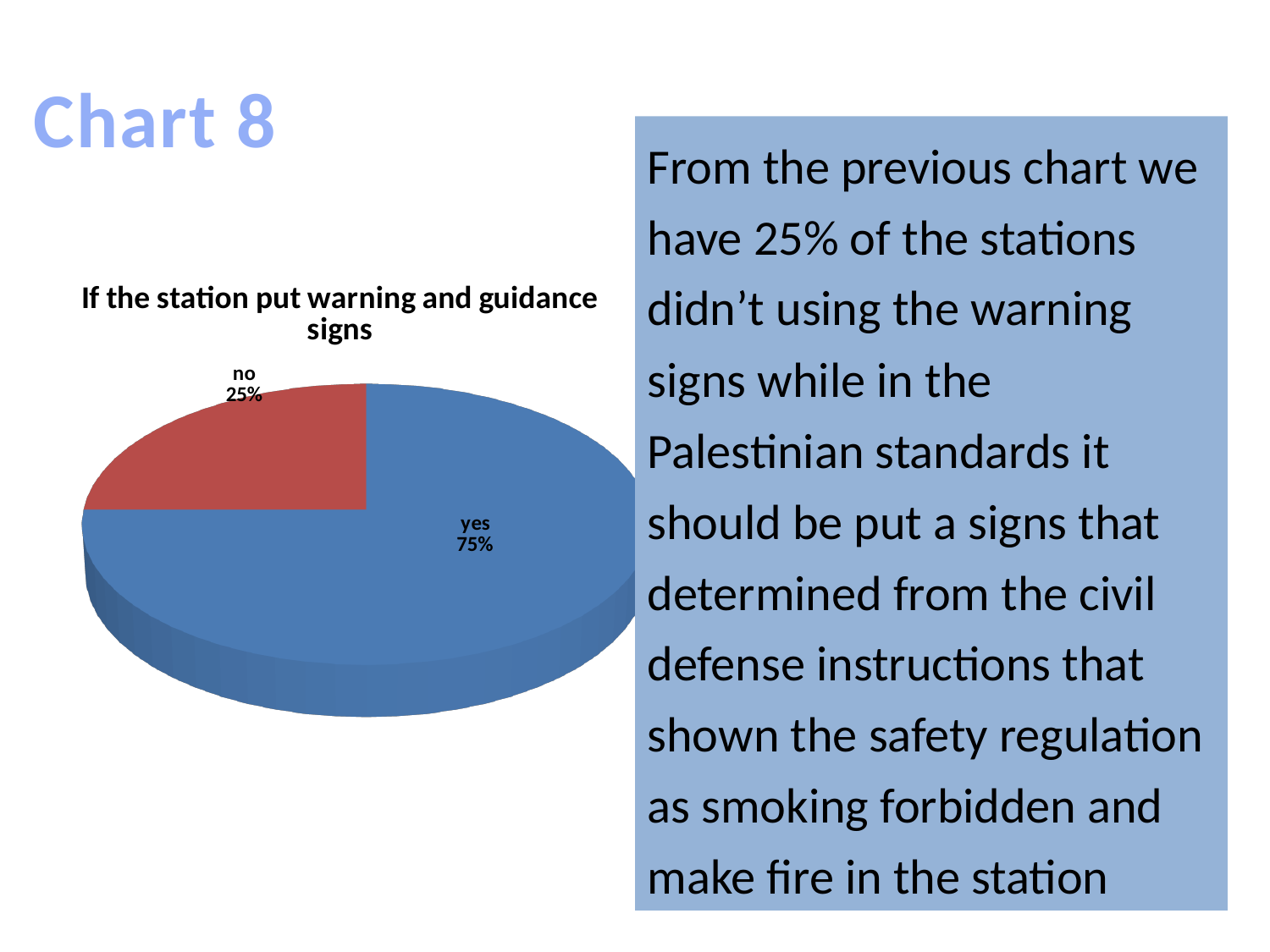
What kind of chart is shown on the slide? pie chart Which category has the largest slice of the pie? yes Which is larger, the "yes" slice or the "no" slice? yes What colour is the "no" slice of the pie? red Which category has the smallest slice of the pie? no What share of the pie does the "yes" slice represent? 75% How many categories are shown in the pie chart? 2 What is the difference in percentage points between the "yes" and "no" slices? 50% What is the title of the chart? If the station put warning and guidance signs What share of the pie does the "no" slice represent? 25%